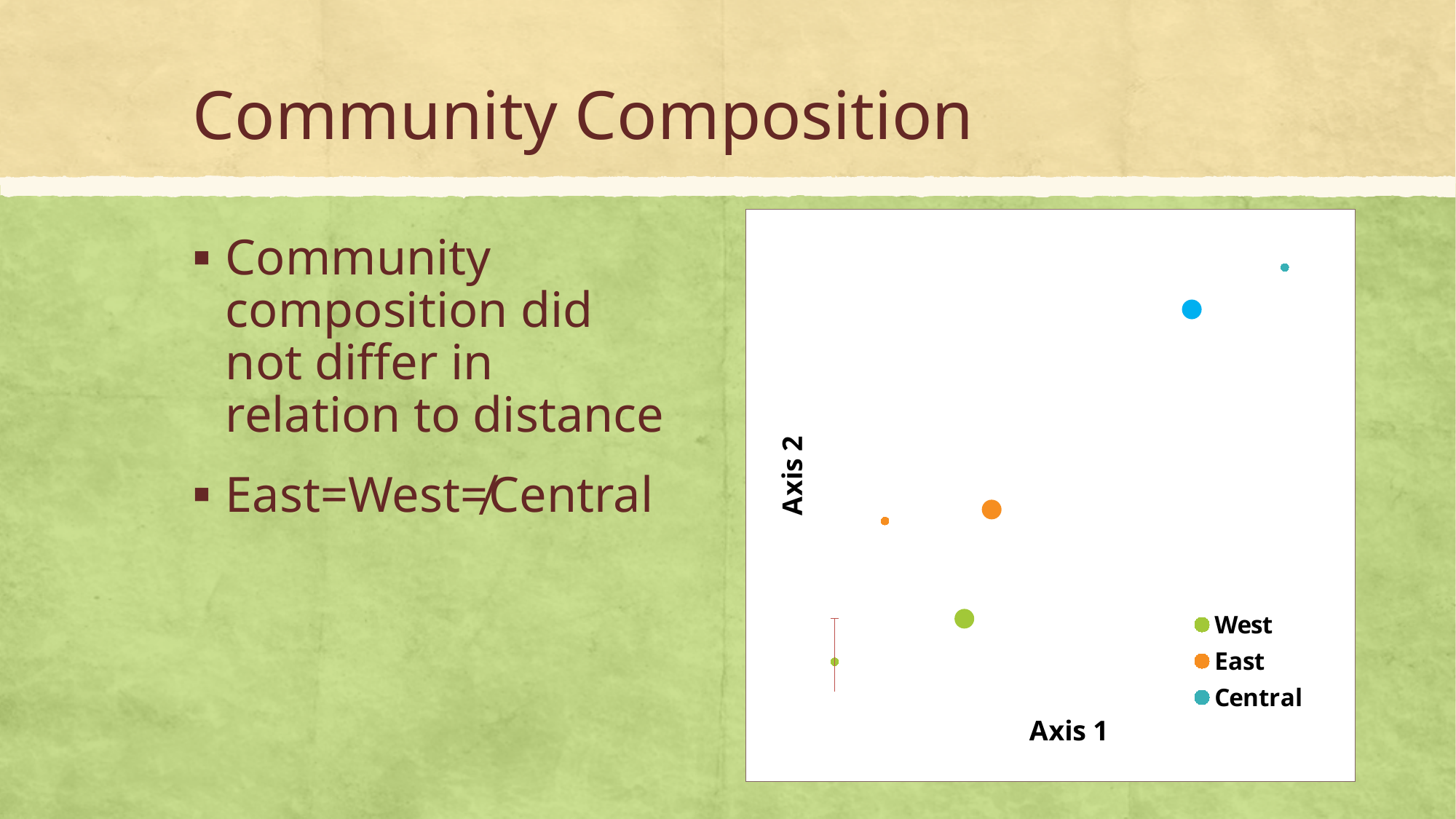
How many series does the chart's legend list? 3 What is the title of the horizontal axis of the chart? Axis 1 What is the title of the vertical axis of the chart? Axis 2 Which series has the points positioned lowest on Axis 2? West How many points are plotted for the Central series? 2 Which series is positioned furthest left on Axis 1? West What are the series names listed in the chart's legend? West, East, Central Which series is positioned higher on Axis 2, East or West? East Which series is positioned further right on Axis 1, Central or West? Central What kind of chart is shown on the slide? scatter chart How many points are plotted in total on the chart? 6 Which series has the points positioned highest on Axis 2? Central